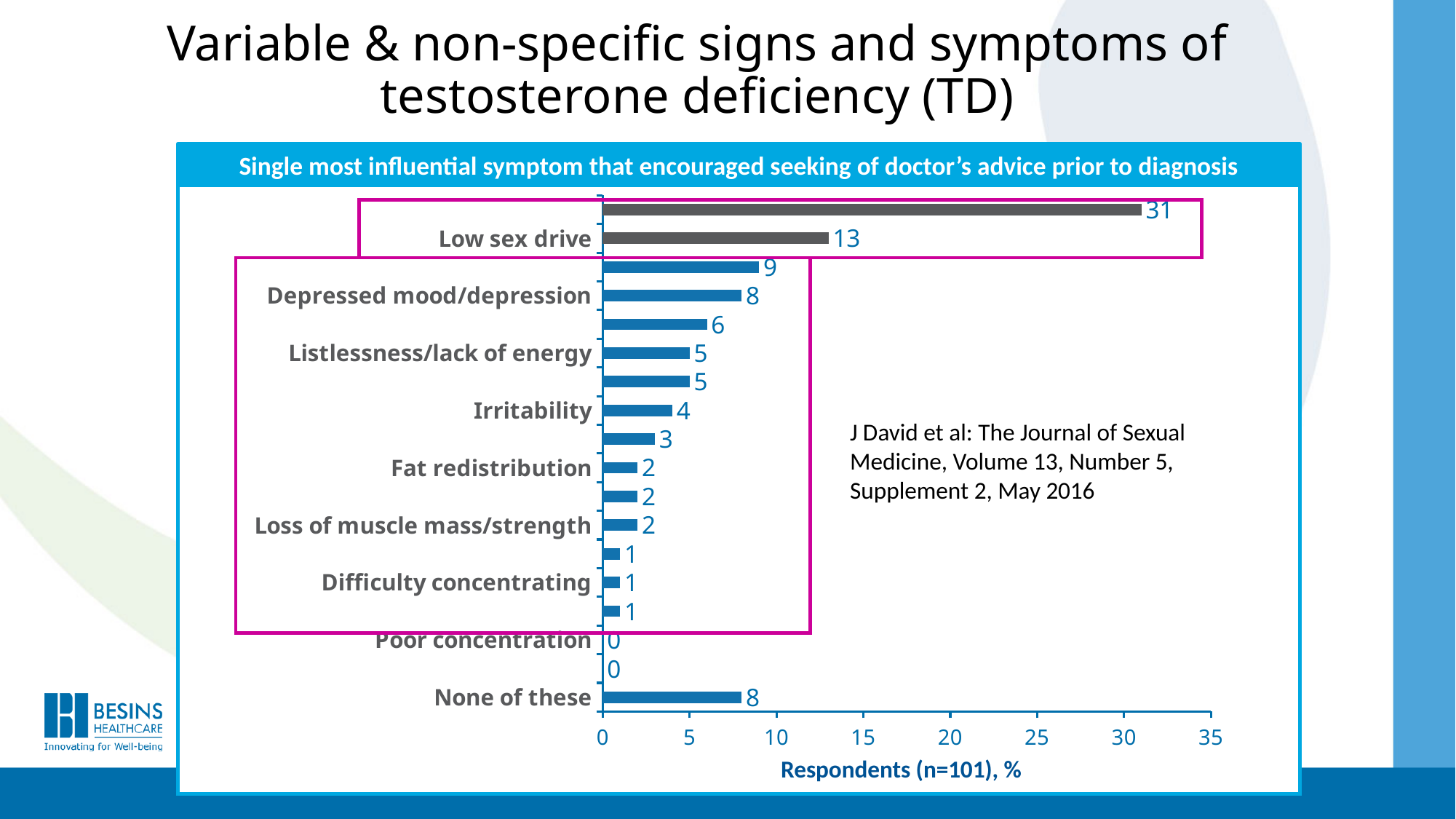
What value is shown for Low sex drive? 13 What value is shown for Depressed mood/depression? 8 What kind of chart is shown on the slide? Bar chart What value is shown for Loss of muscle mass/strength? 2 What is the title of the x axis? Respondents (n=101), % What is the difference between the values for Low sex drive and Irritability? 9 Which is larger, the value for Depressed mood/depression or the value for Listlessness/lack of energy? Depressed mood/depression What value is shown for Poor concentration? 0 What value is shown for None of these? 8 What value is shown for Listlessness/lack of energy? 5 What value is shown for Irritability? 4 What is the largest value labelled on any bar in the chart? 31